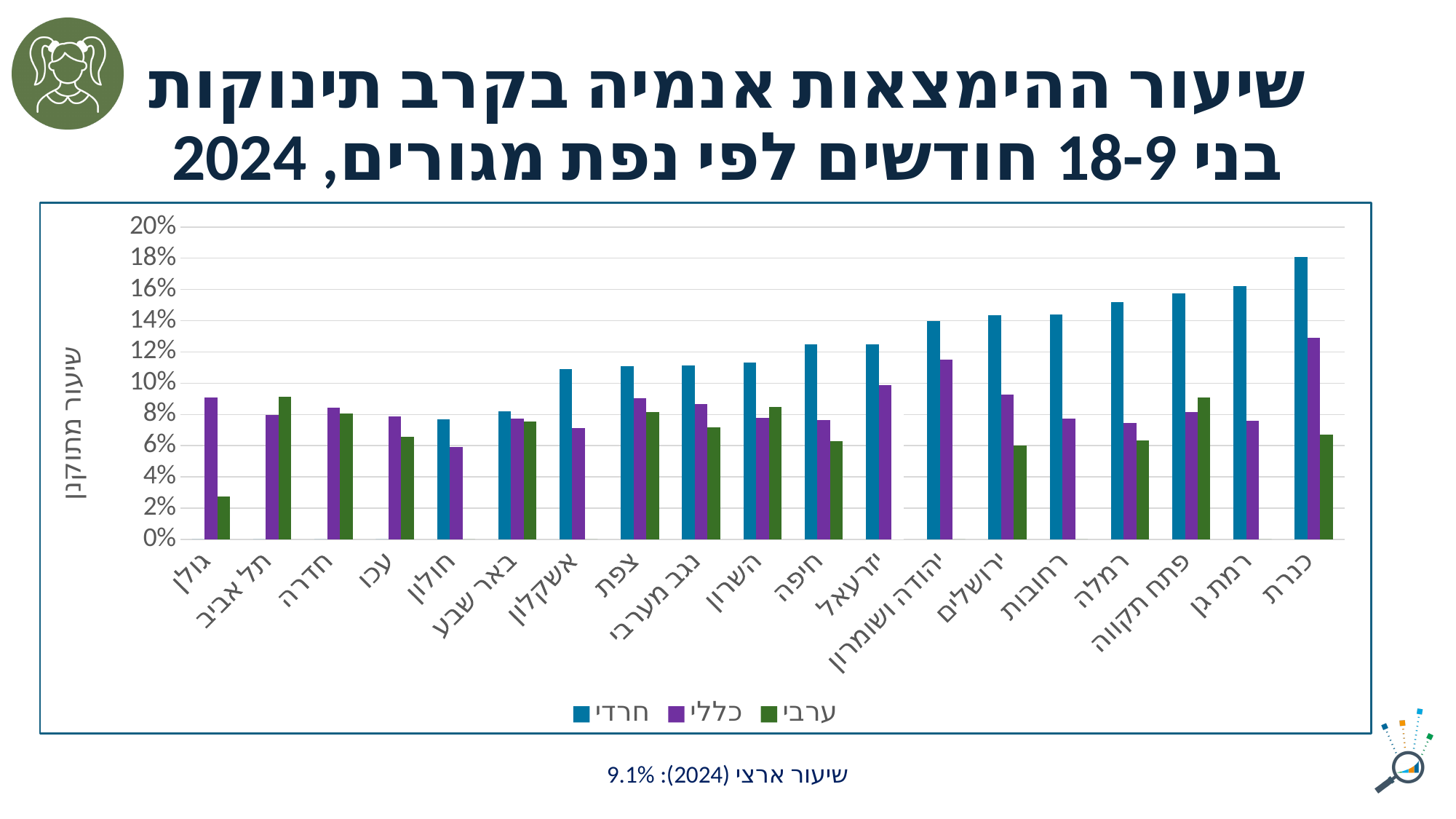
Which series is shown in blue in the legend? חרדי Is the ערבי value for גולן greater or less than 4%? less How many districts (categories) are shown on the x axis? 19 Is the חרדי value for כנרת greater or less than 16%? greater Which district has the highest value for the כללי series? כנרת What kind of chart is shown on the slide? bar chart Is the כללי value for יהודה ושומרון greater or less than 10%? greater Which district has the lowest value for the ערבי series? גולן Do the חרדי values generally rise or fall moving from left to right along the x axis? rise In תל אביב, which is larger: the כללי value or the ערבי value? ערבי Which district has the highest value for the חרדי series? כנרת How many series does the legend list? 3